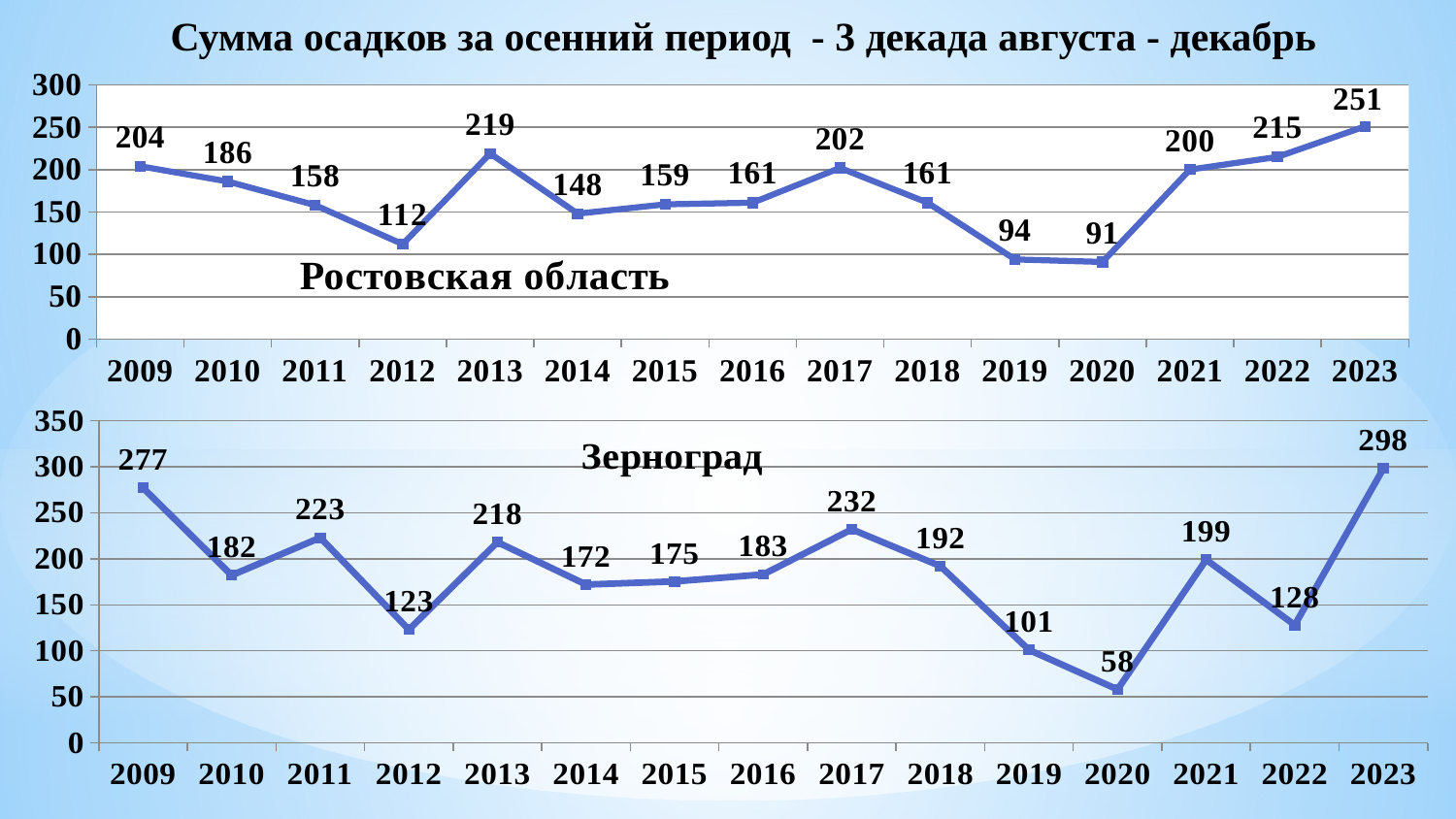
In the top chart (Ростовская область), which year has the highest value? 2023 In the top chart (Ростовская область), which year has the lowest value? 2020 In the top chart (Ростовская область), what is the difference between the values for 2009 and 2012? 92 In the top chart (Ростовская область), is the value for 2019 greater or less than 100? less In the bottom chart (Зерноград), what is the value for 2017? 232 In the top chart (Ростовская область), what is the value for 2013? 219 In the bottom chart (Зерноград), which is larger, the value for 2011 or the value for 2013? 2011 In the bottom chart (Зерноград), do the values rise or fall from 2020 to 2021? rise In the bottom chart (Зерноград), what is the difference between the values for 2023 and 2020? 240 What kind of chart is the top chart (Ростовская область)? line chart In the bottom chart (Зерноград), which year has the lowest value? 2020 How many years are plotted in the bottom chart (Зерноград)? 15